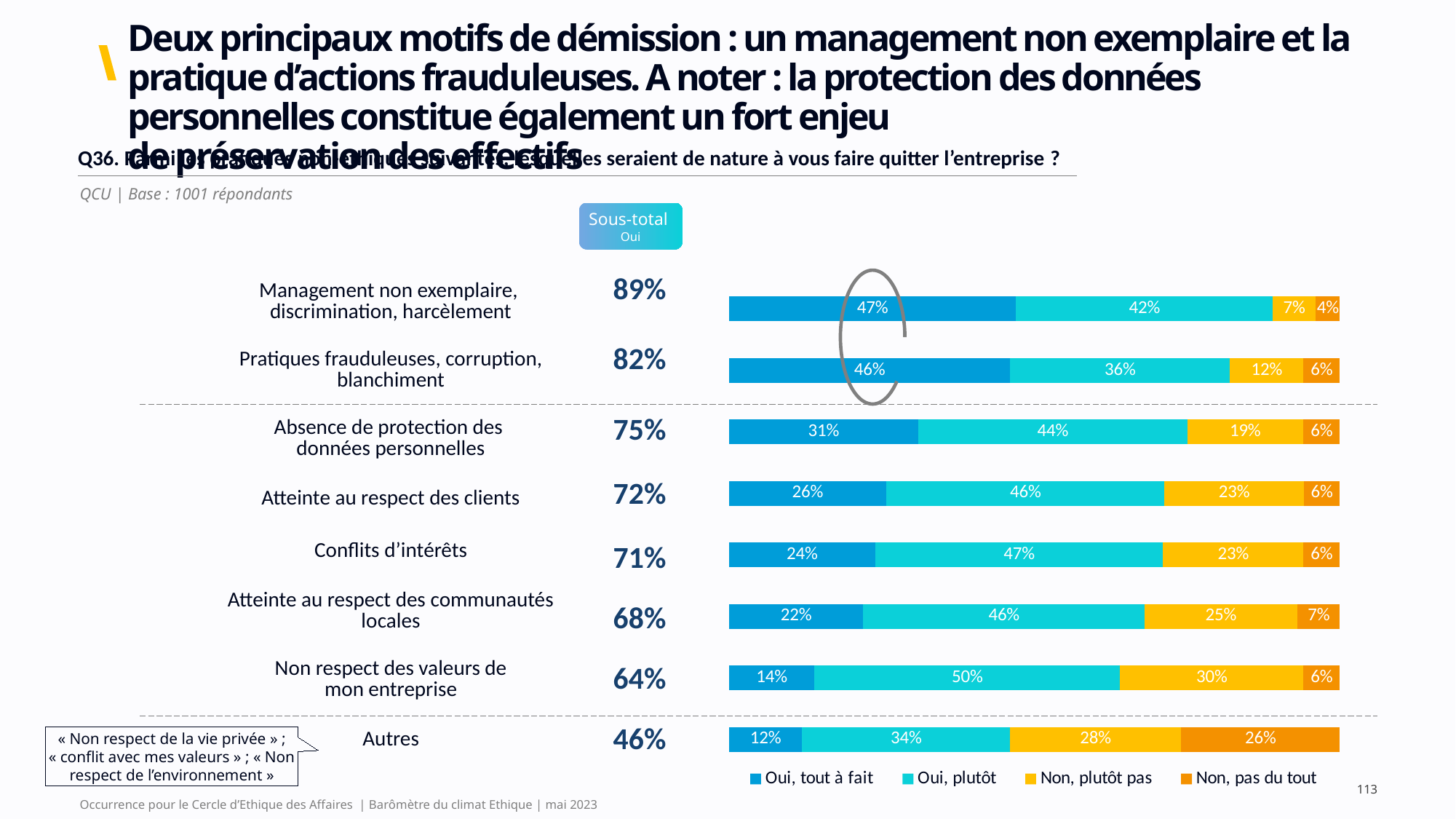
What is the "Sous-total Oui" shown for "Conflits d'intérêts"? 71% Which is larger: the "Non, plutôt pas" value for "Absence de protection des données personnelles" or for "Atteinte au respect des clients"? Atteinte au respect des clients Which legend entry is shown in orange? Non, pas du tout What is the "Non, pas du tout" value for "Autres"? 26% Which category has the lowest "Oui, tout à fait" value? Autres What is the "Non, plutôt pas" value for "Non respect des valeurs de mon entreprise"? 30% What is the difference between the "Oui, plutôt" values for "Non respect des valeurs de mon entreprise" and "Pratiques frauduleuses, corruption, blanchiment"? 14% How many series does the legend list? 4 What is the "Oui, tout à fait" value for "Management non exemplaire, discrimination, harcèlement"? 47% How many categories are plotted in the chart? 8 Which category has the highest "Oui, tout à fait" value? Management non exemplaire, discrimination, harcèlement What kind of chart is shown on the slide? Stacked bar chart